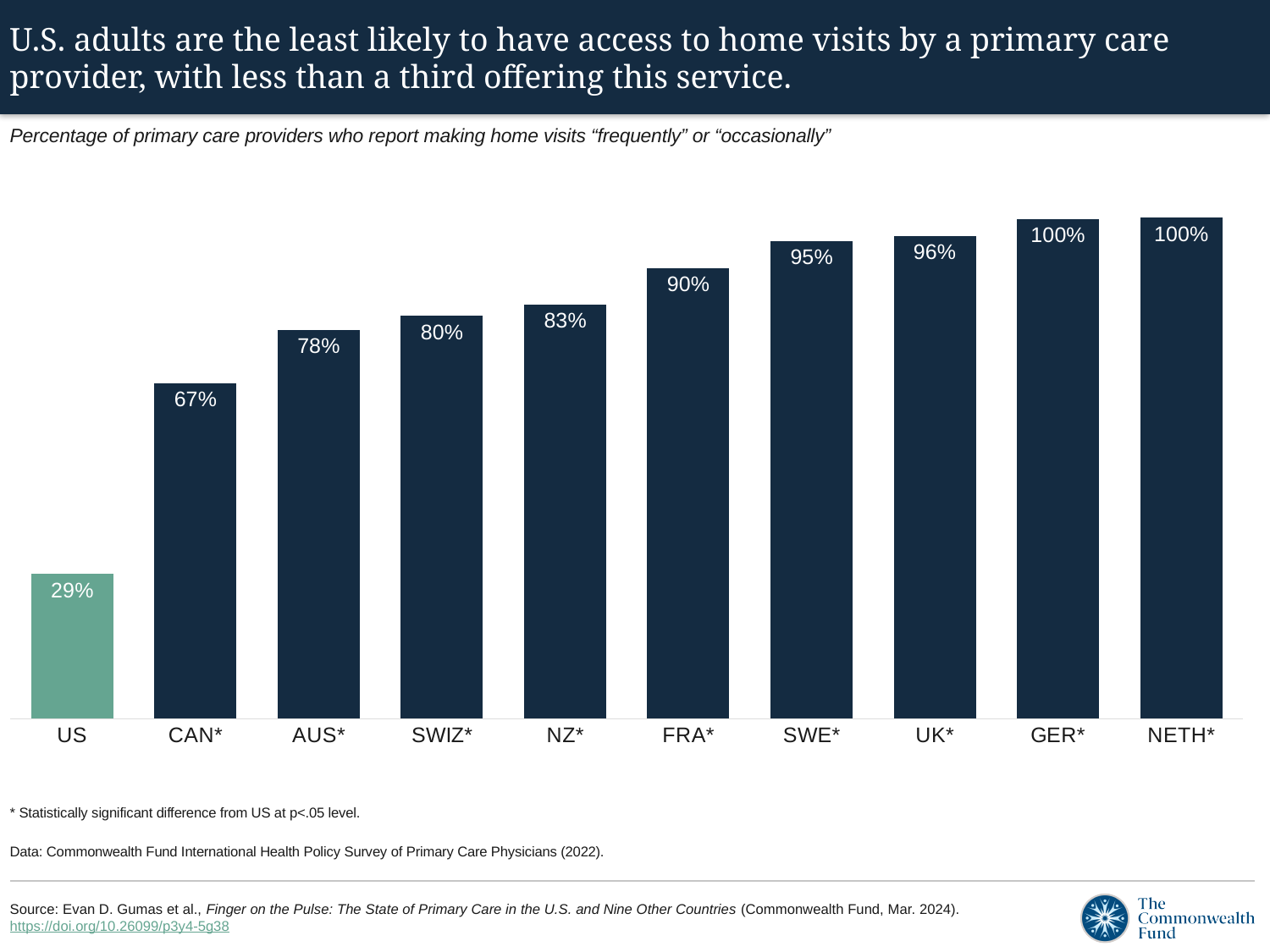
What is the difference between the values for NETH* and US? 71 percentage points Which countries share the highest value on the chart? GER* and NETH* How many countries are shown on the chart? 10 Which country has the lowest percentage of primary care providers making home visits? US Which bar is shown in a different colour from the others? US What is the value shown for SWIZ*? 80% Do the values rise or fall moving from left to right across the chart? Rise What percentage of primary care providers in the US report making home visits frequently or occasionally? 29% Which has a higher value, AUS* or NZ*? NZ* What is the difference between the values for UK* and CAN*? 29 percentage points What is the value shown for FRA*? 90% What type of chart is shown on the slide? Bar chart